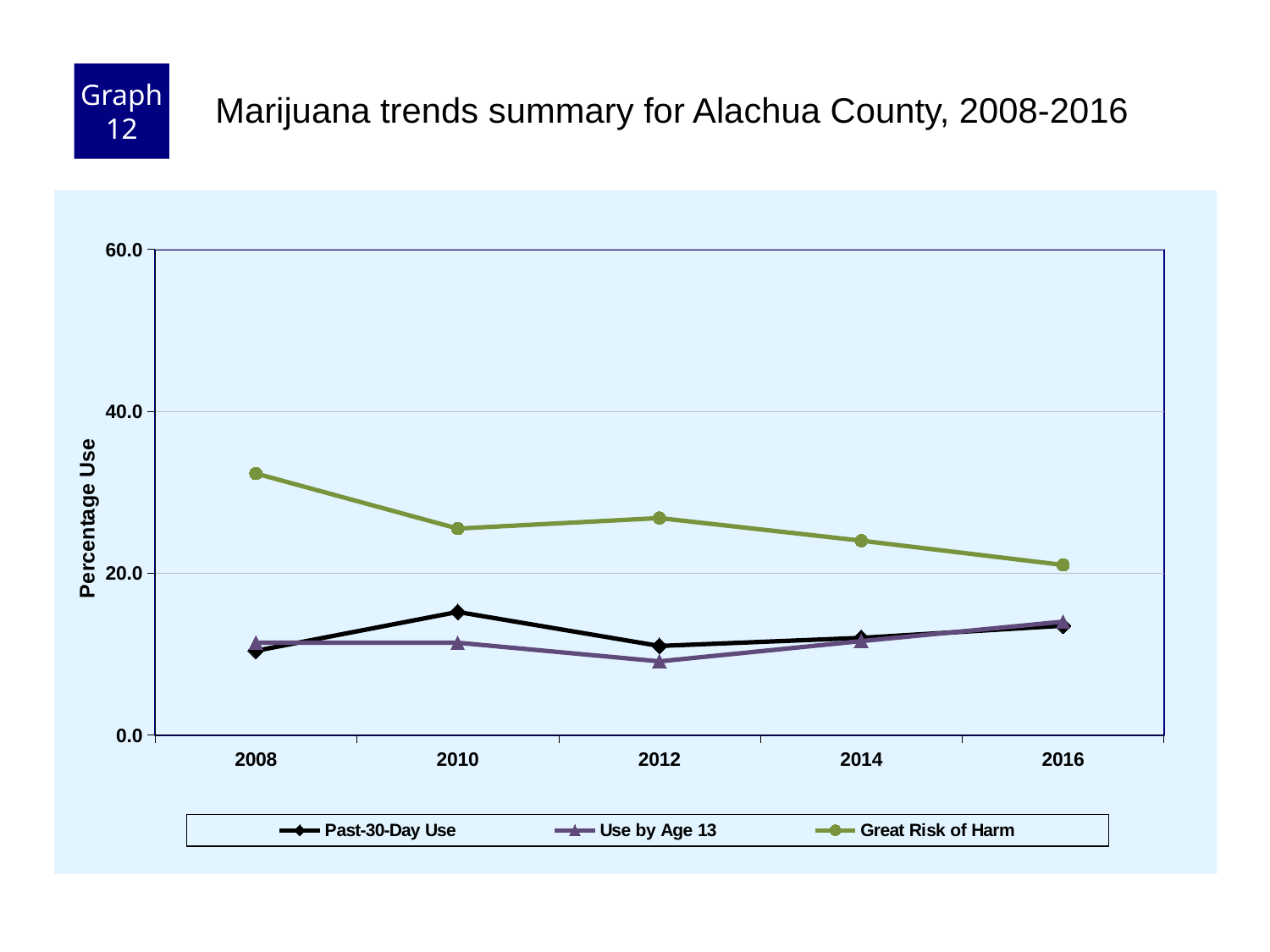
What is the label on the y axis? Percentage Use Which series has the larger value in 2012, Great Risk of Harm or Past-30-Day Use? Great Risk of Harm Is the value for Great Risk of Harm in 2016 greater or less than 40.0? less In which year is Use by Age 13 at its lowest? 2012 In which year is the Great Risk of Harm series at its lowest? 2016 How many years are plotted along the x axis? 5 Is the value for Past-30-Day Use in 2010 greater or less than 20.0? less What kind of chart is shown on the slide? line chart Is the value for Great Risk of Harm in 2008 greater or less than 20.0? greater In which year is the Great Risk of Harm series at its highest? 2008 How many series does the legend list? 3 In which year is Past-30-Day Use at its highest? 2010